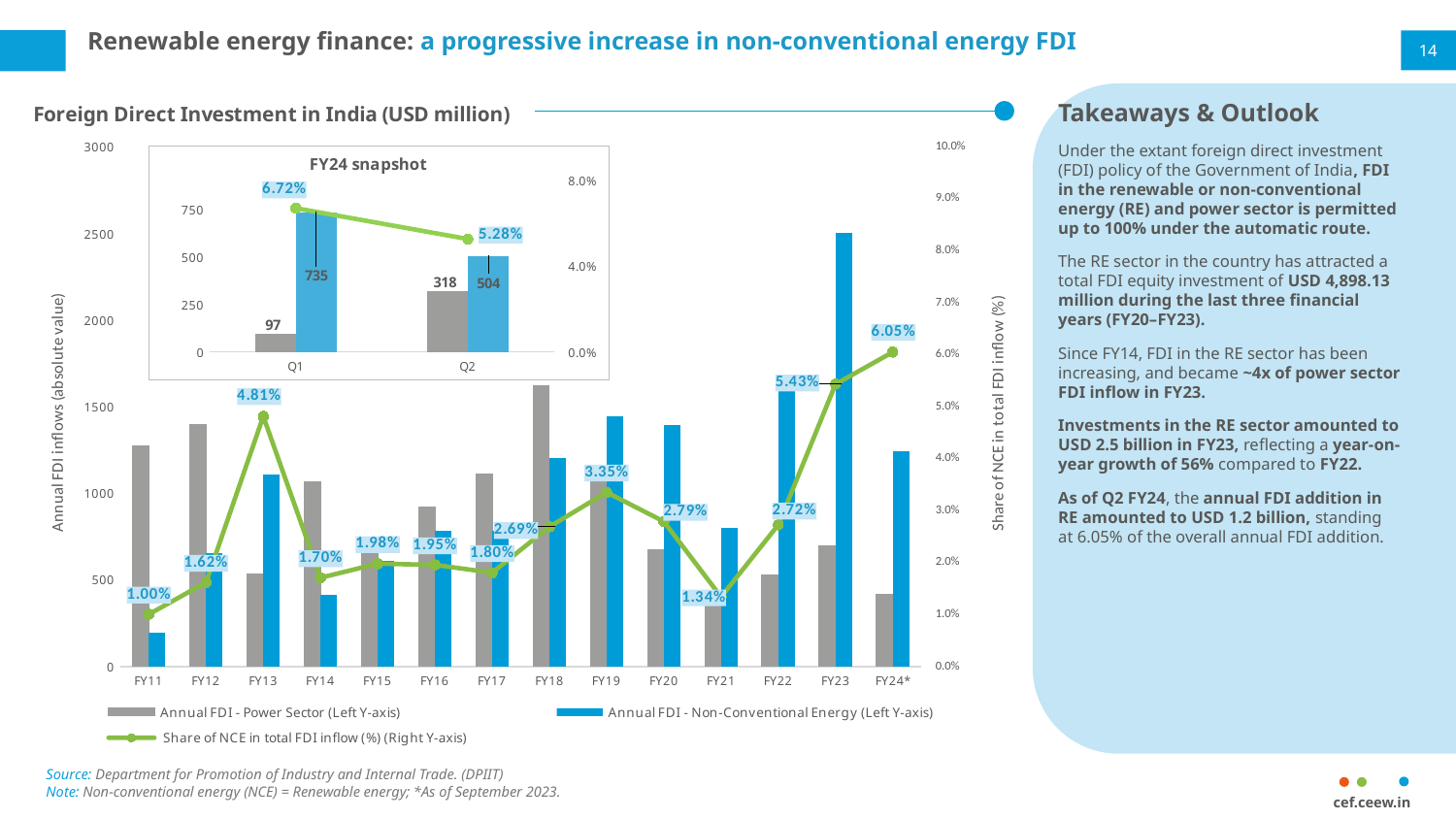
In the main chart 'Foreign Direct Investment in India (USD million)', how many series does the legend list? 3 In the main chart 'Foreign Direct Investment in India (USD million)', which fiscal year has the lowest share of NCE in total FDI inflow? FY11 In the main chart 'Foreign Direct Investment in India (USD million)', by how many percentage points does the share of NCE in FY24* exceed that of FY23? 0.62 percentage points In the main chart 'Foreign Direct Investment in India (USD million)', which is larger: the share of NCE in FY13 or in FY19? FY13 In the main chart 'Foreign Direct Investment in India (USD million)', how many fiscal years are shown on the x axis? 14 In the main chart 'Foreign Direct Investment in India (USD million)', which fiscal year has the highest share of NCE in total FDI inflow? FY24* In the main chart 'Foreign Direct Investment in India (USD million)', is the Annual FDI - Power Sector value for FY11 greater or less than 1000? greater In the main chart 'Foreign Direct Investment in India (USD million)', does the share of NCE in total FDI inflow rise or fall from FY21 to FY24*? rise In the main chart 'Foreign Direct Investment in India (USD million)', what is the share of NCE in total FDI inflow for FY23? 5.43% In the inset 'FY24 snapshot' chart, what is the Annual FDI - Power Sector value for Q2? 318 In the inset 'FY24 snapshot' chart, what is the Annual FDI - Non-Conventional Energy value for Q1? 735 In the inset 'FY24 snapshot' chart, what is the difference between the Non-Conventional Energy values for Q1 and Q2? 231